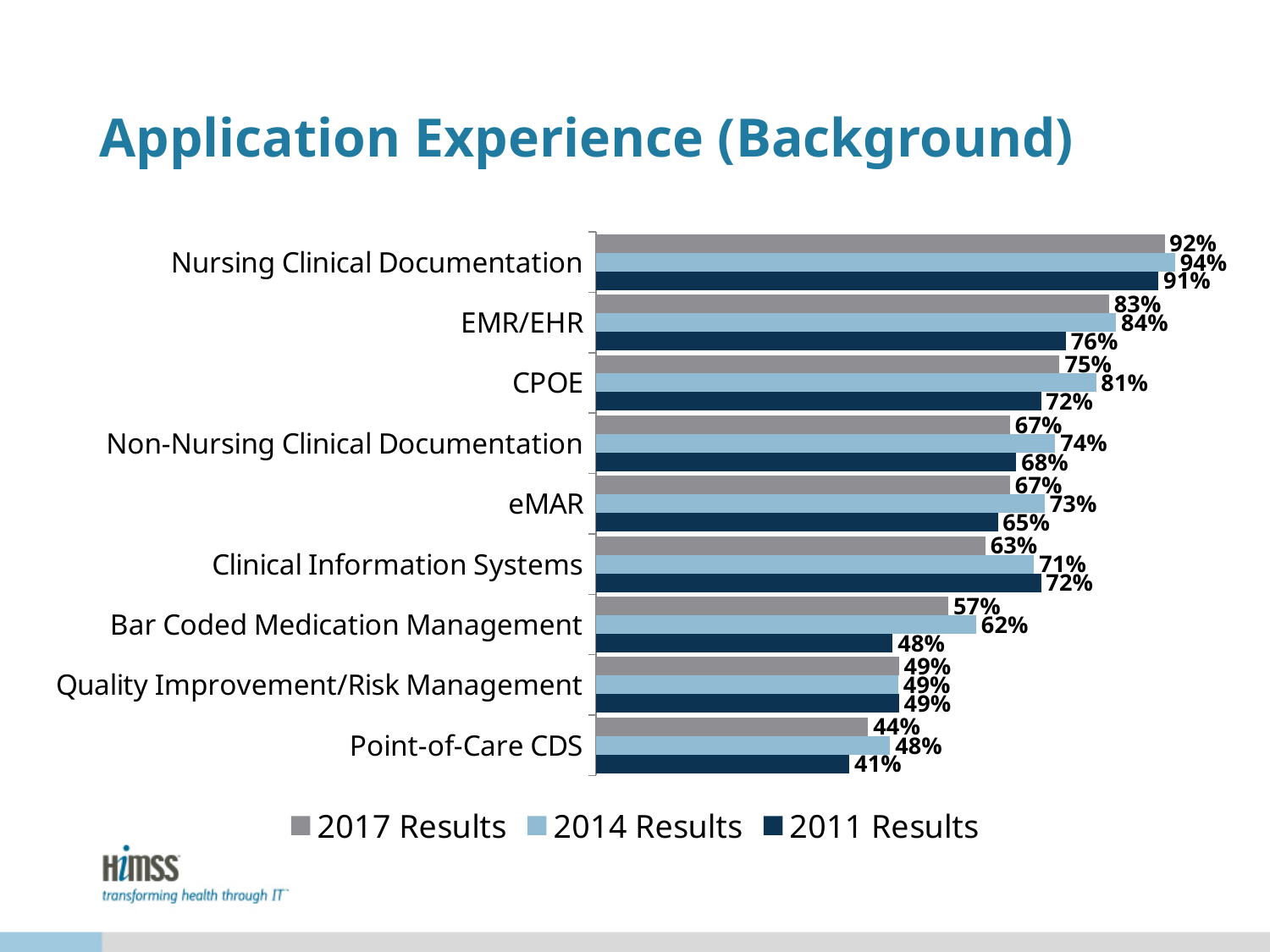
What kind of chart is shown on the slide? Bar chart What is the 2017 Results value for Point-of-Care CDS? 44% How many series does the legend list? 3 How many categories are shown on the chart? 9 What is the difference between the 2014 Results and 2011 Results values for Bar Coded Medication Management? 14% What is the 2014 Results value for Nursing Clinical Documentation? 94% What is the title of the slide? Application Experience (Background) What is the 2017 Results value for Clinical Information Systems? 63% Which is larger for CPOE: the 2017 Results value or the 2014 Results value? 2014 Results Which category has the lowest 2011 Results value? Point-of-Care CDS What is the 2011 Results value for EMR/EHR? 76% Which category has the highest 2017 Results value? Nursing Clinical Documentation